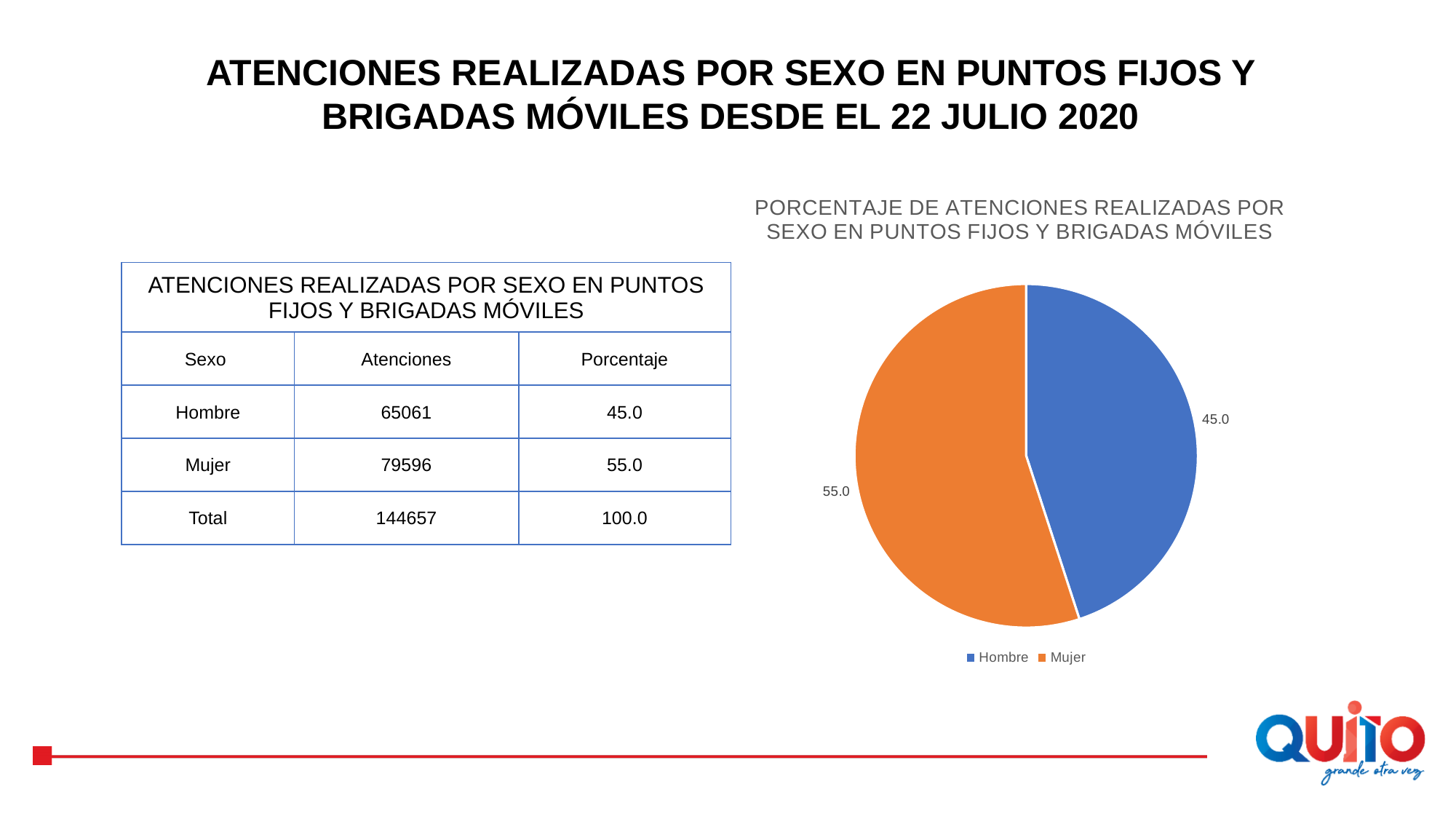
What is the title of the pie chart? PORCENTAJE DE ATENCIONES REALIZADAS POR SEXO EN PUNTOS FIJOS Y BRIGADAS MÓVILES What is the value shown for Mujer in the pie chart? 55.0 What is the difference between the Mujer and Hombre values in the pie chart? 10.0 How many slices does the pie chart have? 2 How many entries does the pie chart legend list? 2 Which category has the largest slice in the pie chart? Mujer Which is larger in the pie chart, Hombre or Mujer? Mujer Which category has the smallest slice in the pie chart? Hombre What is the value shown for Hombre in the pie chart? 45.0 What share of the pie does the Hombre slice represent? 45.0 What colour is the Mujer slice in the pie chart? orange What kind of chart is shown on the slide? pie chart